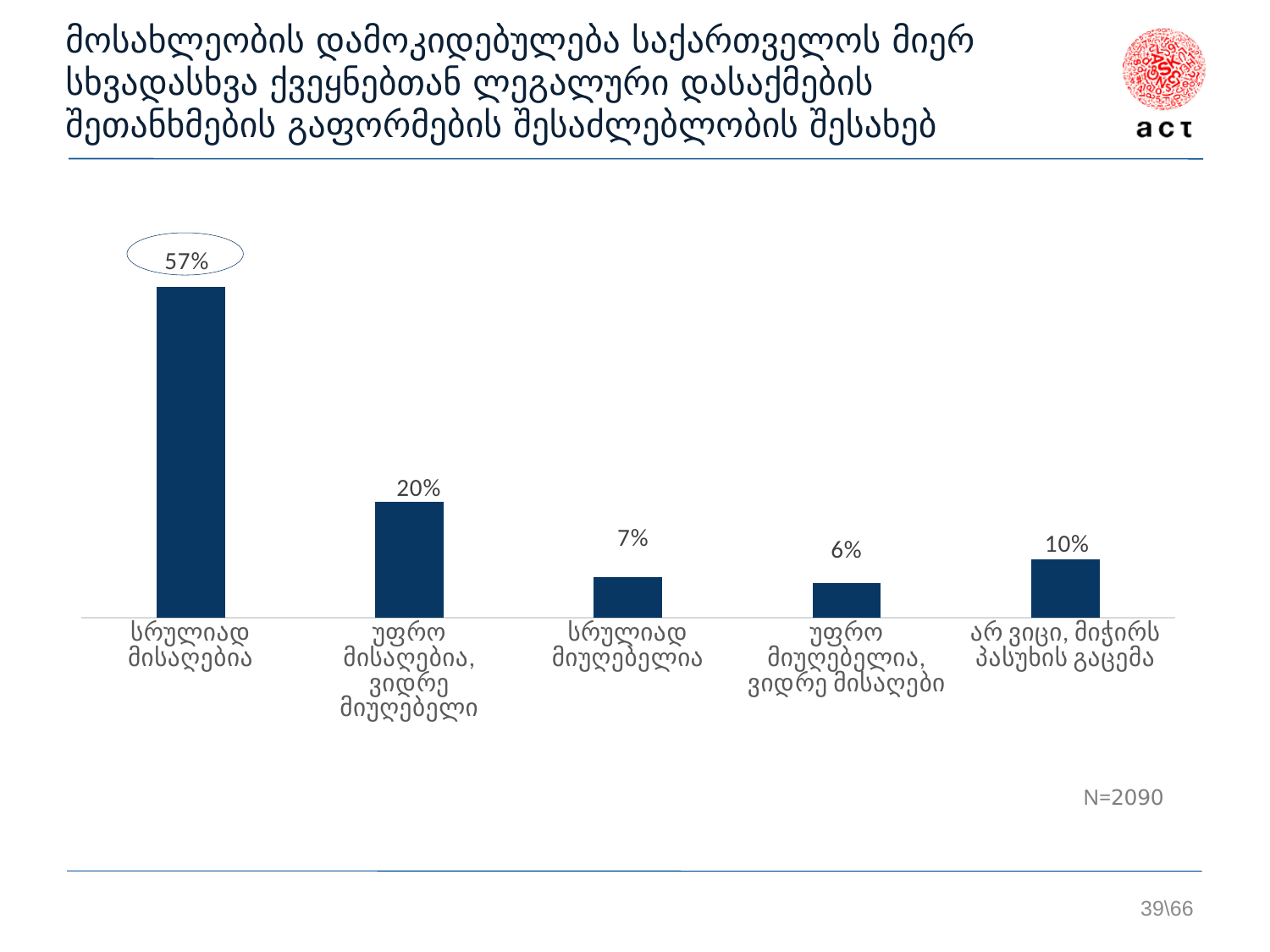
What is the value for the category "არ ვიცი, მიჭირს პასუხის გაცემა"? 10% What is the value for the category "უფრო მისაღებია, ვიდრე მიუღებელი"? 20% Which category has the highest value? სრულიად მისაღებია Which is larger: the value for "სრულიად მიუღებელია" or the value for "არ ვიცი, მიჭირს პასუხის გაცემა"? არ ვიცი, მიჭირს პასუხის გაცემა What is the difference between the values for "სრულიად მისაღებია" and "უფრო მისაღებია, ვიდრე მიუღებელი"? 37% What is the value for the category "სრულიად მიუღებელია"? 7% What is the difference between the values for "არ ვიცი, მიჭირს პასუხის გაცემა" and "უფრო მიუღებელია, ვიდრე მისაღები"? 4% What kind of chart is shown on the slide? Bar chart What is the value for the category "სრულიად მისაღებია"? 57% Which category has the lowest value? უფრო მიუღებელია, ვიდრე მისაღები How many categories are shown in the chart? 5 What sample size (N) is stated on the slide? N=2090